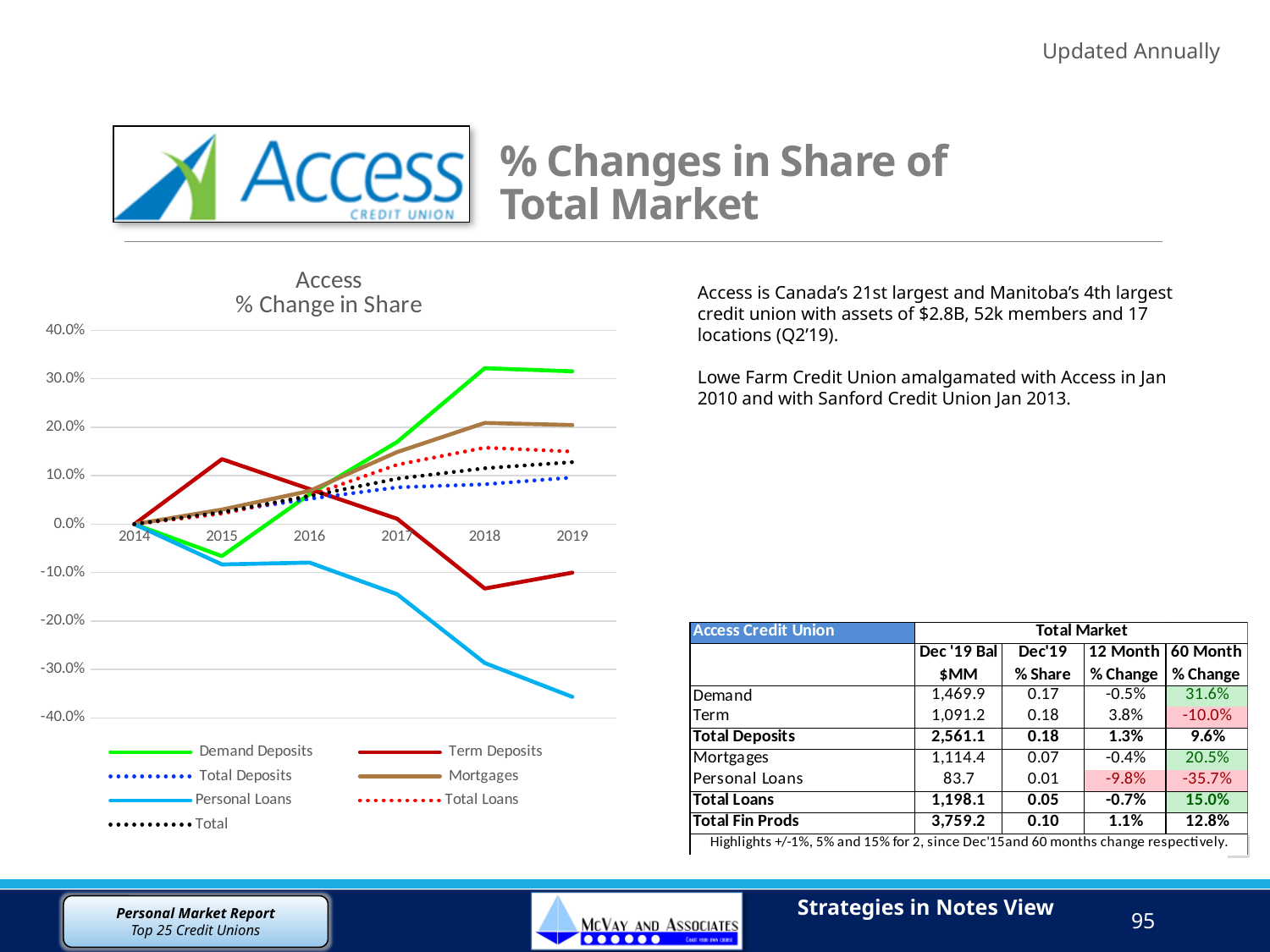
In the "Access % Change in Share" chart, which is larger in 2019: Mortgages or Total Deposits? Mortgages What kind of chart is the "Access % Change in Share" chart? line chart How many series does the legend of the "Access % Change in Share" chart list? 7 In the "Access % Change in Share" chart, is the value for Personal Loans in 2019 greater or less than -30.0%? less In the "Access % Change in Share" chart, is the value for Mortgages in 2019 greater or less than 10.0%? greater In the "Access % Change in Share" chart, which series is drawn as a black dotted line? Total In the "Access % Change in Share" chart, which series has the lowest value in 2019? Personal Loans In the "Access % Change in Share" chart, is the value for Term Deposits in 2015 greater or less than 10.0%? greater In the "Access % Change in Share" chart, which series has the highest value in 2019? Demand Deposits How many years are plotted along the x axis of the "Access % Change in Share" chart? 6 In the "Access % Change in Share" chart, does the Personal Loans series generally rise or fall from 2014 to 2019? fall